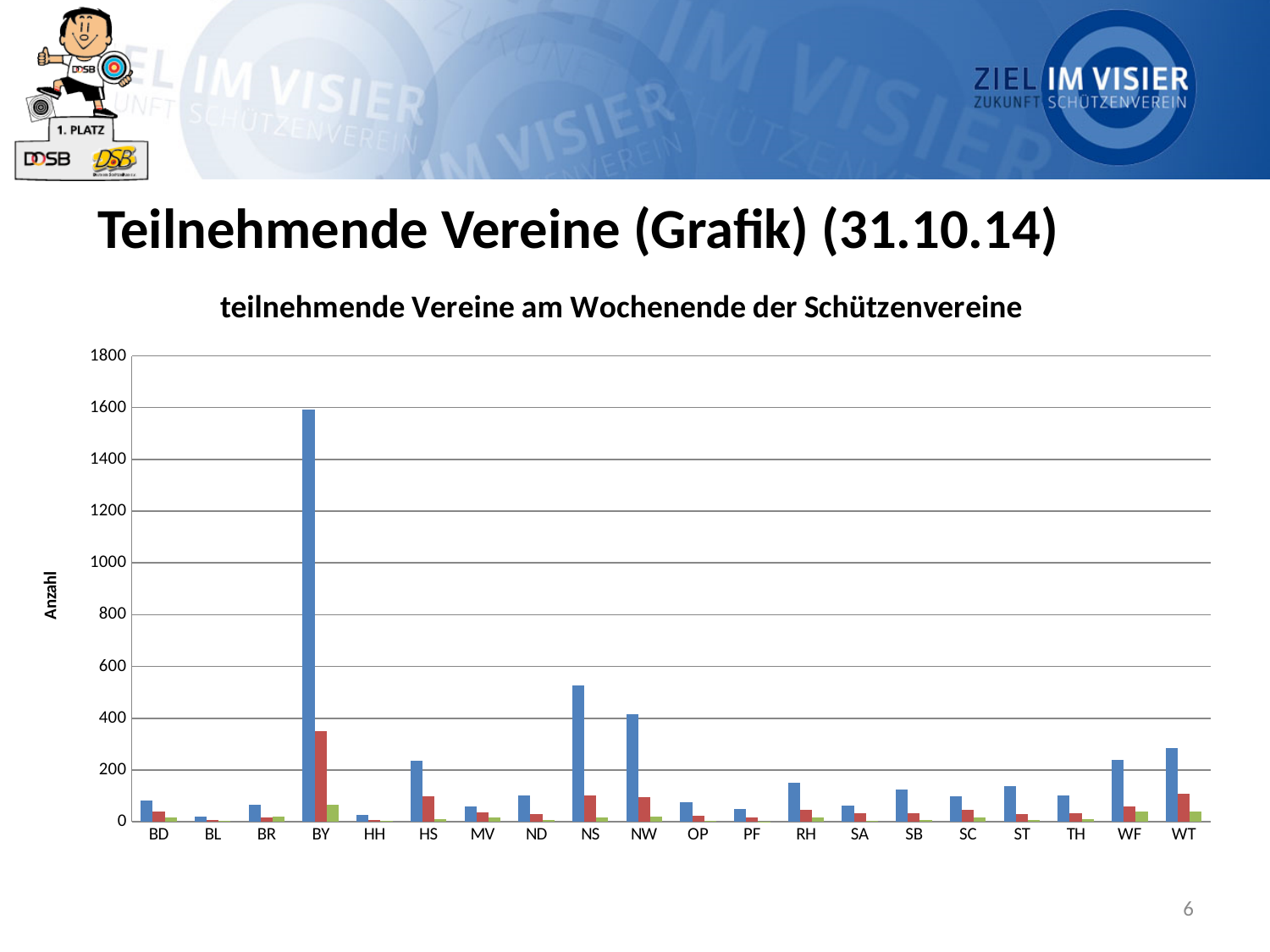
Which category has the tallest bar in the chart? BY Which category has the lowest blue bar in the chart? BL Which has the larger blue bar, WT or WF? WT What is the label of the y axis of the chart? Anzahl What kind of chart is shown on the slide? bar chart Is the value of the blue bar for OP greater or less than 200? less Is the value of the blue bar for BY greater or less than 1400? greater Is the value of the blue bar for NS greater or less than 400? greater How many categories are shown along the x axis of the chart? 20 What is the title of the chart? teilnehmende Vereine am Wochenende der Schützenvereine Which has the larger blue bar, NS or NW? NS